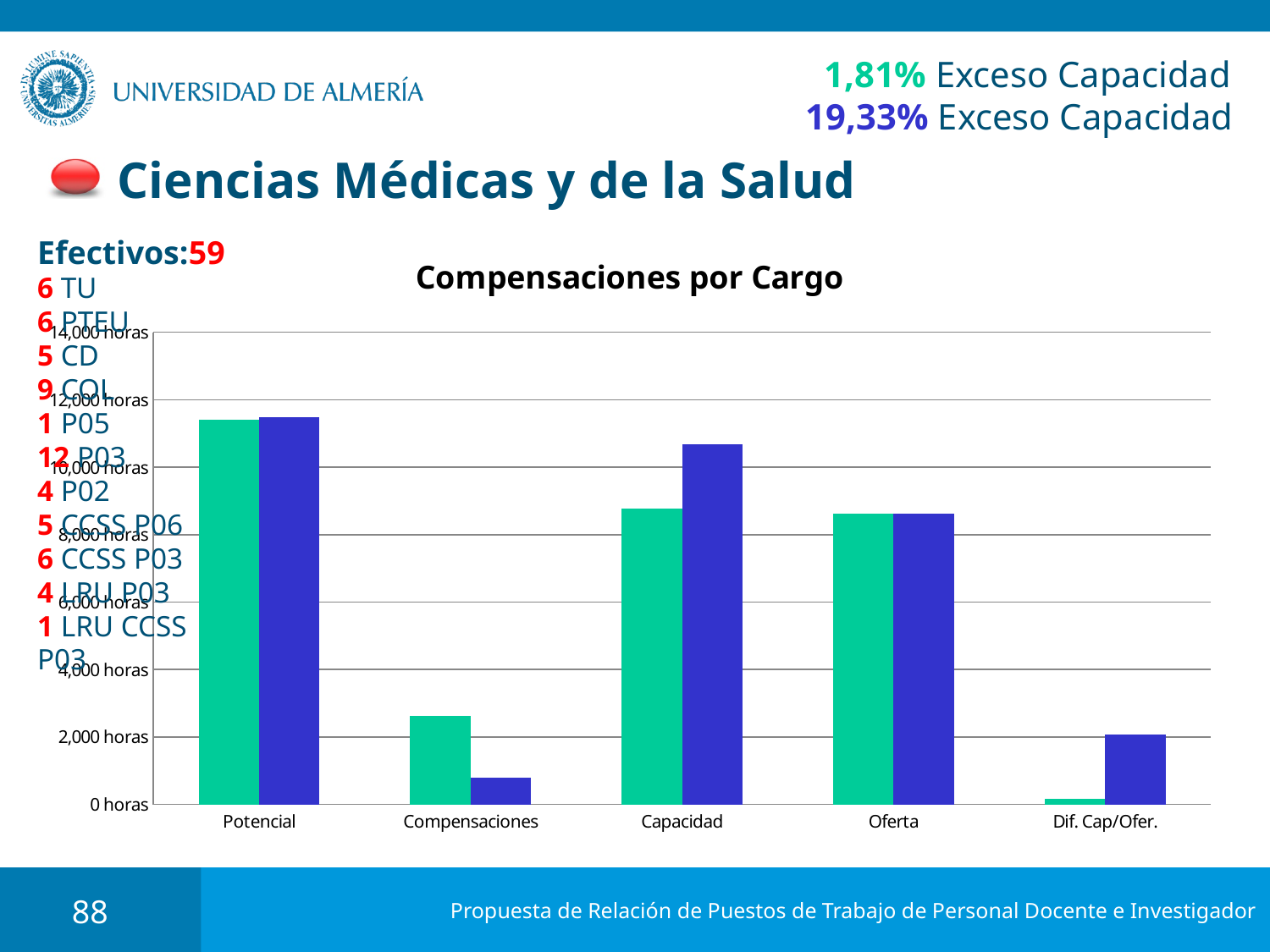
Which category has the highest teal bar? Potencial For Compensaciones, which bar is larger, the teal one or the blue one? the teal one Which category has the lowest blue bar? Compensaciones How many categories are shown on the x axis of the chart? 5 For Capacidad, which bar is larger, the teal one or the blue one? the blue one Which category has the lowest teal bar? Dif. Cap/Ofer. Is the teal bar for Dif. Cap/Ofer. greater or less than 2,000 horas? less Is the blue bar for Capacidad greater or less than 10,000 horas? greater Is the blue bar for Compensaciones greater or less than 2,000 horas? less What kind of chart is shown on the slide? bar chart What is the title of the chart? Compensaciones por Cargo